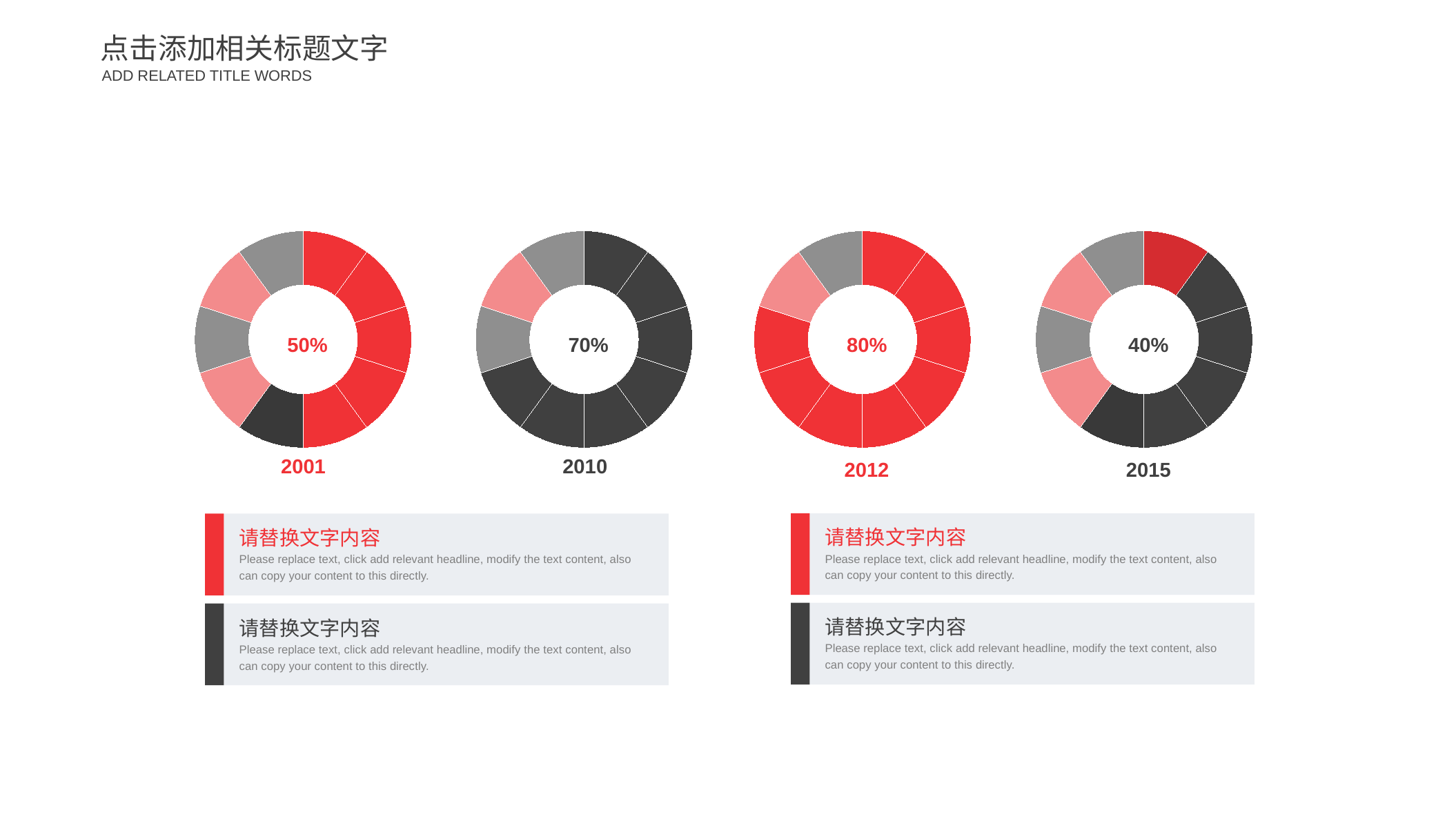
What percentage is shown in the centre of the donut chart labelled 2010? 70% What percentage is shown in the centre of the donut chart labelled 2001? 50% Which year's donut chart shows the lowest percentage? 2015 What percentage is shown in the centre of the donut chart labelled 2012? 80% Which shows a larger percentage, the 2001 chart or the 2010 chart? 2010 What percentage is shown in the centre of the donut chart labelled 2015? 40% What kind of chart is used to show the percentage for each year? Donut (pie) chart Which colour is used for the filled portion of the 2012 donut chart? Red What is the difference between the percentage shown for 2010 and the percentage shown for 2001? 20% How many donut charts are on the slide? 4 Which year's donut chart shows the highest percentage? 2012 What is the difference between the percentage shown for 2012 and the percentage shown for 2015? 40%